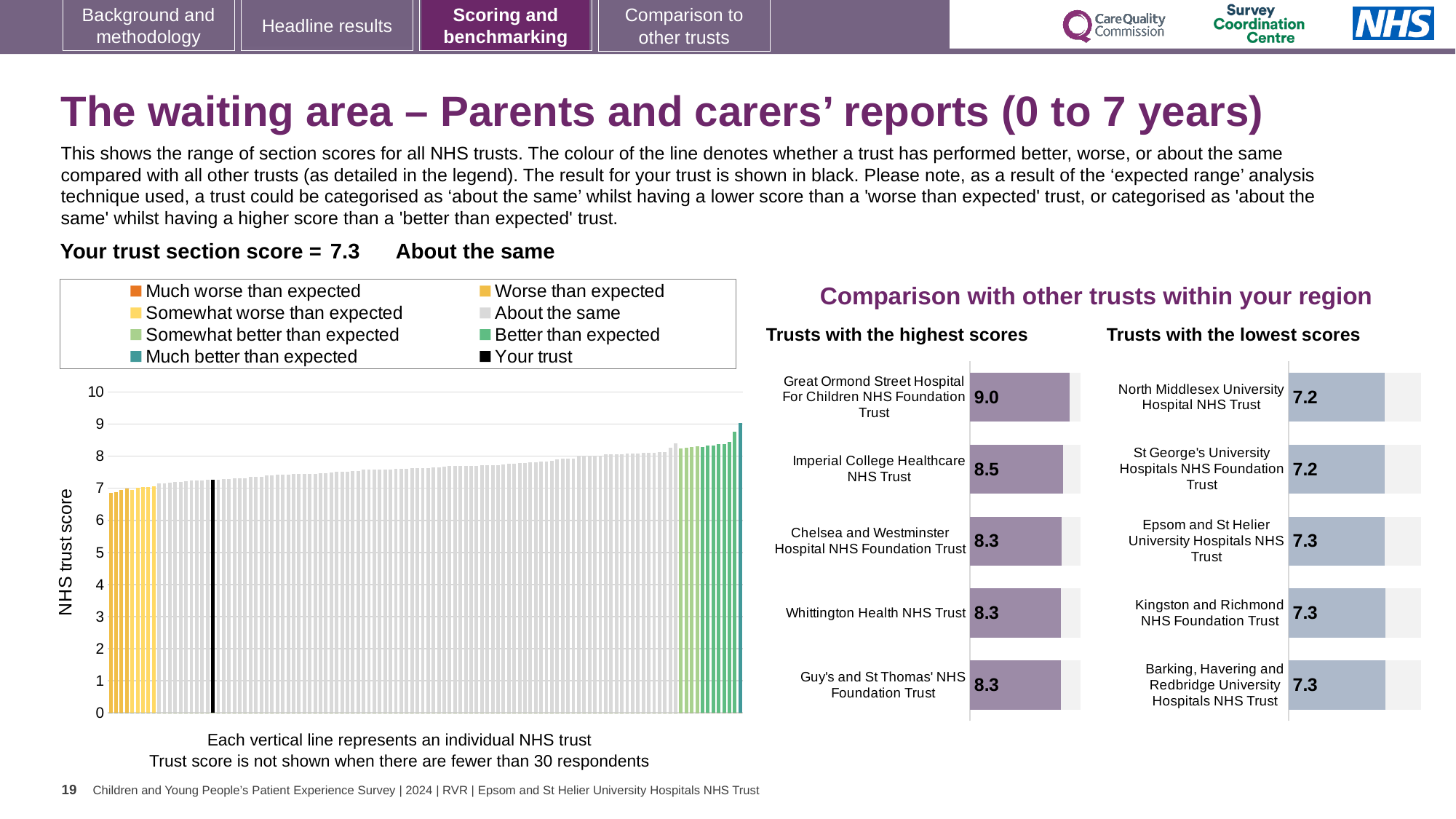
In the 'Trusts with the highest scores' chart, what is the score for Imperial College Healthcare NHS Trust? 8.5 In the 'Trusts with the highest scores' chart, what is the difference between the scores of Great Ormond Street Hospital For Children NHS Foundation Trust and Imperial College Healthcare NHS Trust? 0.5 Which is larger: the score for Whittington Health NHS Trust in the 'Trusts with the highest scores' chart or the score for Kingston and Richmond NHS Foundation Trust in the 'Trusts with the lowest scores' chart? Whittington Health NHS Trust How many entries does the legend of the 'NHS trust score' chart on the left list? 8 In the 'NHS trust score' chart on the left, is the value of the tallest bar greater or less than 8? greater In the 'NHS trust score' chart on the left, do the bar values rise or fall from left to right? Rise How many trusts are shown in the 'Trusts with the lowest scores' chart? 5 In the 'Trusts with the lowest scores' chart, what is the score for North Middlesex University Hospital NHS Trust? 7.2 What kind of chart is the 'NHS trust score' chart on the left of the slide? Bar chart In the 'Trusts with the highest scores' chart, which trust has the highest score? Great Ormond Street Hospital For Children NHS Foundation Trust In the 'Trusts with the highest scores' chart, what is the score for Great Ormond Street Hospital For Children NHS Foundation Trust? 9.0 In the 'Trusts with the lowest scores' chart, what is the score for Barking, Havering and Redbridge University Hospitals NHS Trust? 7.3